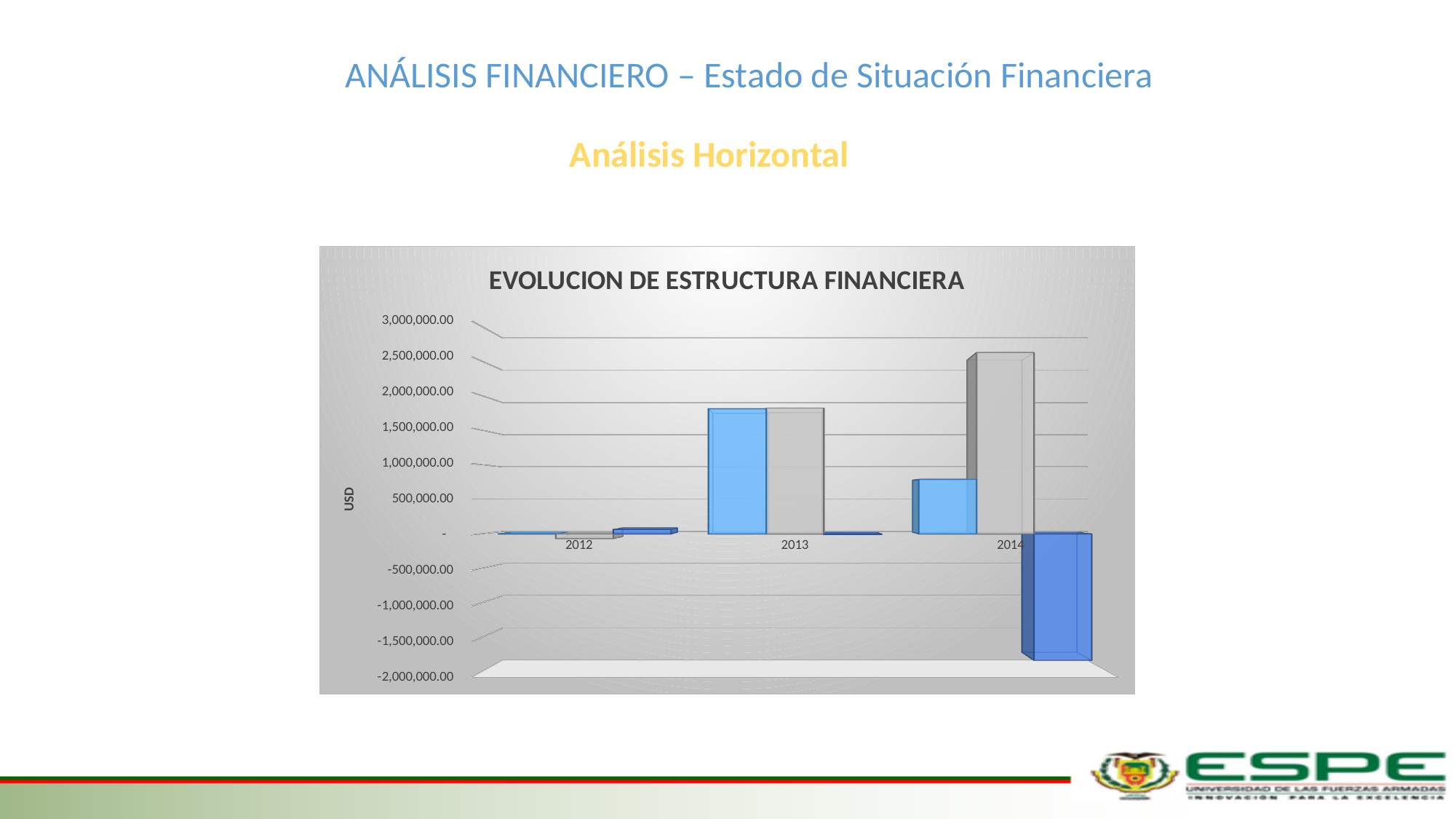
Is the value of the dark blue bar for 2014 greater or less than -1,000,000.00? less Which year has the tallest gray bar? 2014 Do the gray bars rise or fall from 2012 to 2014? rise What is the title of the chart? EVOLUCION DE ESTRUCTURA FINANCIERA Which is larger, the light blue bar for 2013 or the light blue bar for 2014? 2013 In which year is the dark blue bar at its lowest value? 2014 Is the value of the gray bar for 2014 greater or less than 2,000,000.00? greater What label is shown on the vertical axis of the chart? USD What kind of chart is shown on the slide? bar chart Is the value of the light blue bar for 2013 greater or less than 1,500,000.00? greater How many years are shown on the x axis of the chart? 3